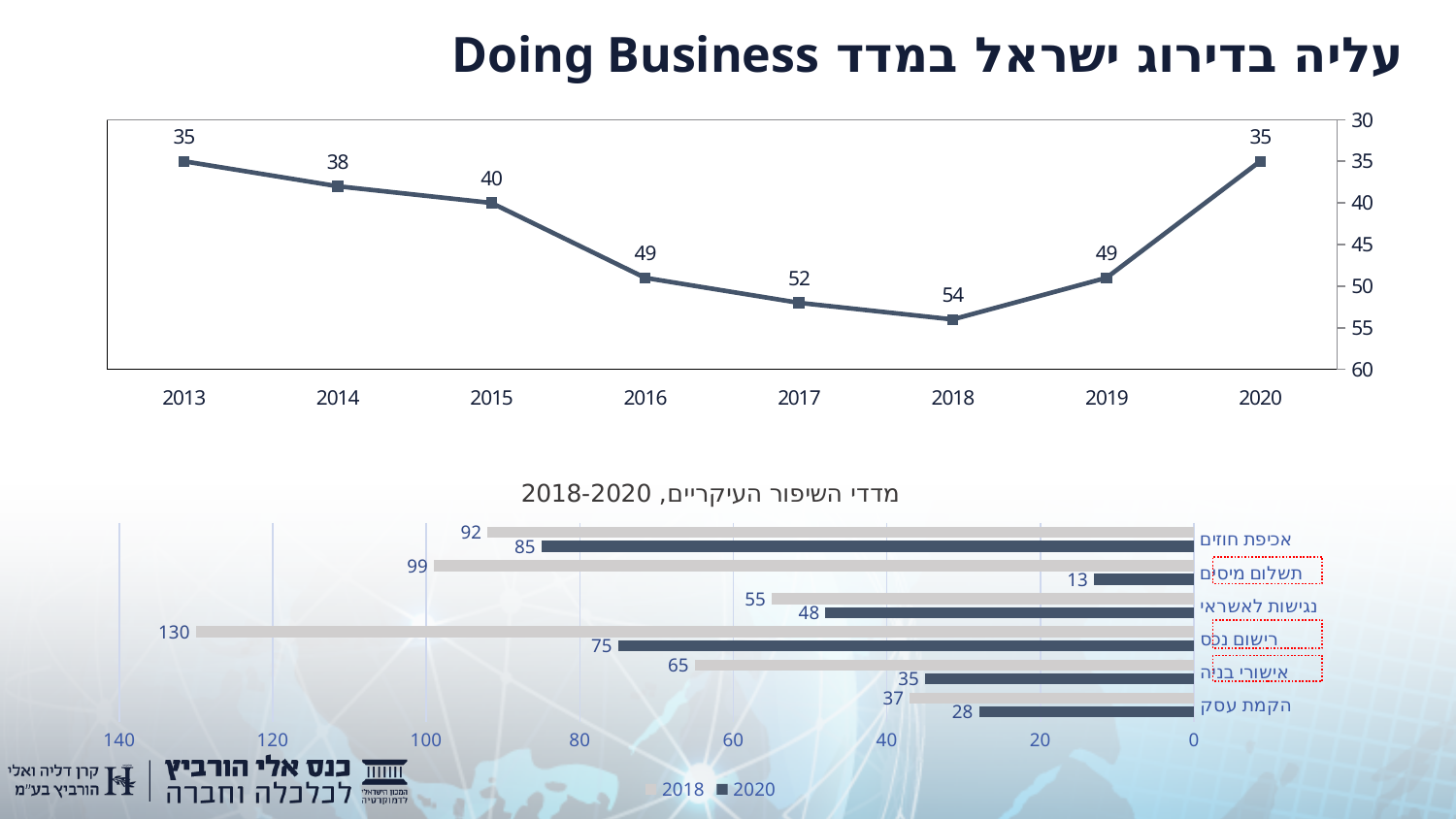
In the top line chart, what is the difference between the values for 2018 and 2013? 19 In the top line chart, which year has the highest plotted value? 2018 In the bottom bar chart, which category has the lowest 2020 value? תשלום מיסים What kind of chart is the top chart on the slide? line chart In the top line chart, what is the value for 2016? 49 How many series does the legend of the bottom bar chart list? 2 In the top line chart, how many years are plotted on the x axis? 8 In the bottom bar chart, what is the 2020 value for תשלום מיסים? 13 In the bottom bar chart, what is the difference between the 2018 and 2020 values for אישורי בניה? 30 In the top line chart, what is the value for 2020? 35 In the bottom bar chart, what is the 2018 value for רישום נכס? 130 In the top line chart, do the values rise or fall from 2013 to 2018? rise